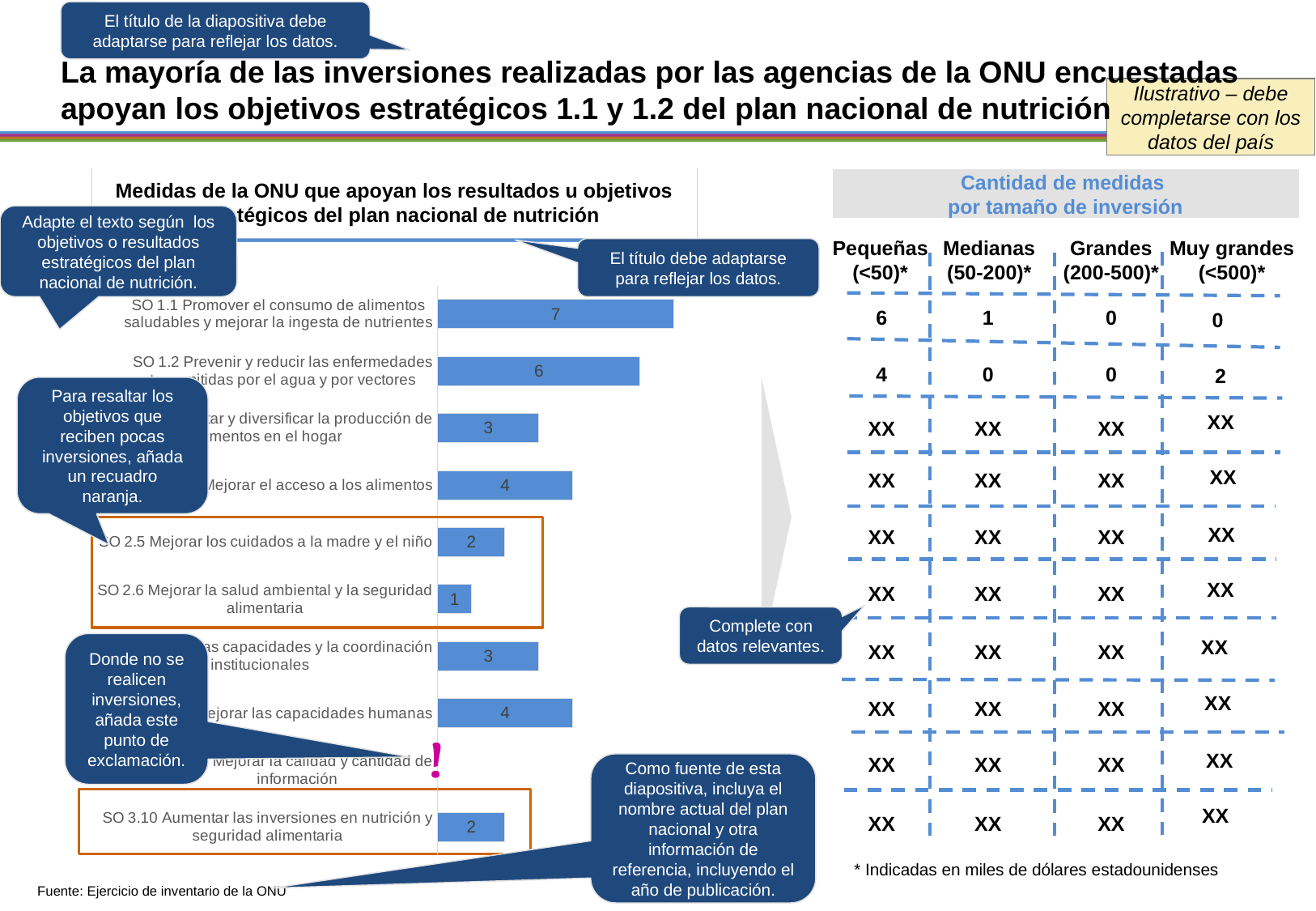
What type of chart is shown on the left of the slide? bar chart What is the value for SO 3.10 Aumentar las inversiones en nutrición y seguridad alimentaria? 2 What is the value for SO 2.6 Mejorar la salud ambiental y la seguridad alimentaria? 1 What is the difference between the values for SO 1.1 and SO 1.2? 1 Which labelled bar has the lowest value in the bar chart? SO 2.6 Mejorar la salud ambiental y la seguridad alimentaria What is the value for SO 1.1 Promover el consumo de alimentos saludables y mejorar la ingesta de nutrientes? 7 What is the source cited below the bar chart? Ejercicio de inventario de la ONU Which category has the highest value in the bar chart? SO 1.1 Promover el consumo de alimentos saludables y mejorar la ingesta de nutrientes Which is larger, the value for SO 2.5 Mejorar los cuidados a la madre y el niño or the value for SO 2.6 Mejorar la salud ambiental y la seguridad alimentaria? SO 2.5 Mejorar los cuidados a la madre y el niño What is the value for the category 'Mejorar el acceso a los alimentos'? 4 What is the value for SO 1.2 Prevenir y reducir las enfermedades transmitidas por el agua y por vectores? 6 What is the value for SO 2.5 Mejorar los cuidados a la madre y el niño? 2